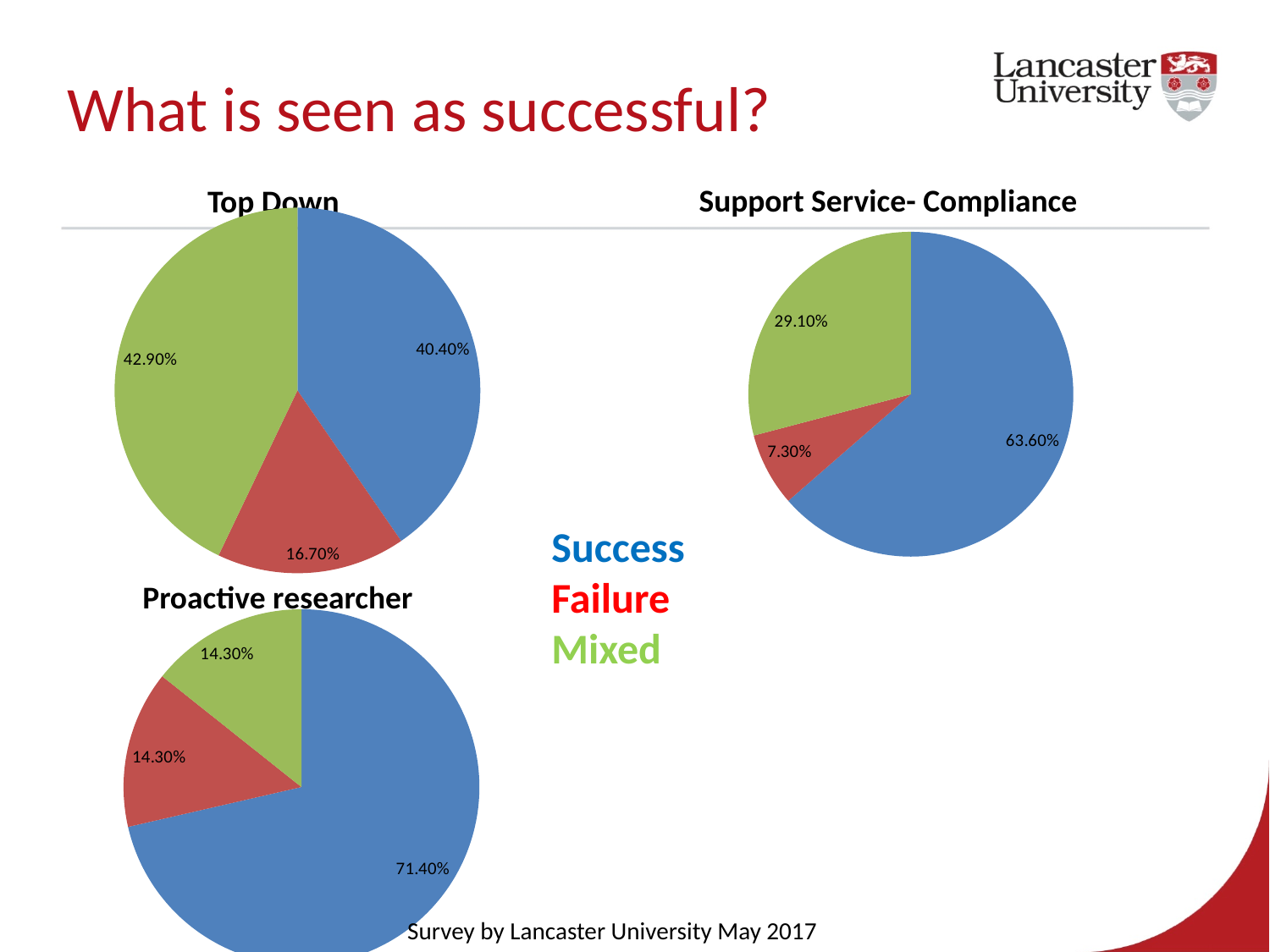
In the Support Service- Compliance chart, what share is labelled for the Success (blue) slice? 63.60% What type of chart is the Support Service- Compliance chart? Pie chart In the Top Down chart, what share is labelled for the Success (blue) slice? 40.40% Which chart shows the larger Success share, Top Down or Proactive researcher? Proactive researcher In the Top Down chart, which category has the largest slice? Mixed In the Proactive researcher chart, what share is labelled for the Mixed (green) slice? 14.30% In the Proactive researcher chart, what share is labelled for the Success (blue) slice? 71.40% In the Support Service- Compliance chart, what is the difference between the Success and Mixed shares? 34.50% In the Top Down chart, what share is labelled for the Failure (red) slice? 16.70% How many pie charts are shown on the slide? 3 In the Support Service- Compliance chart, which category has the smallest slice? Failure How many slices does the Top Down pie chart have? 3